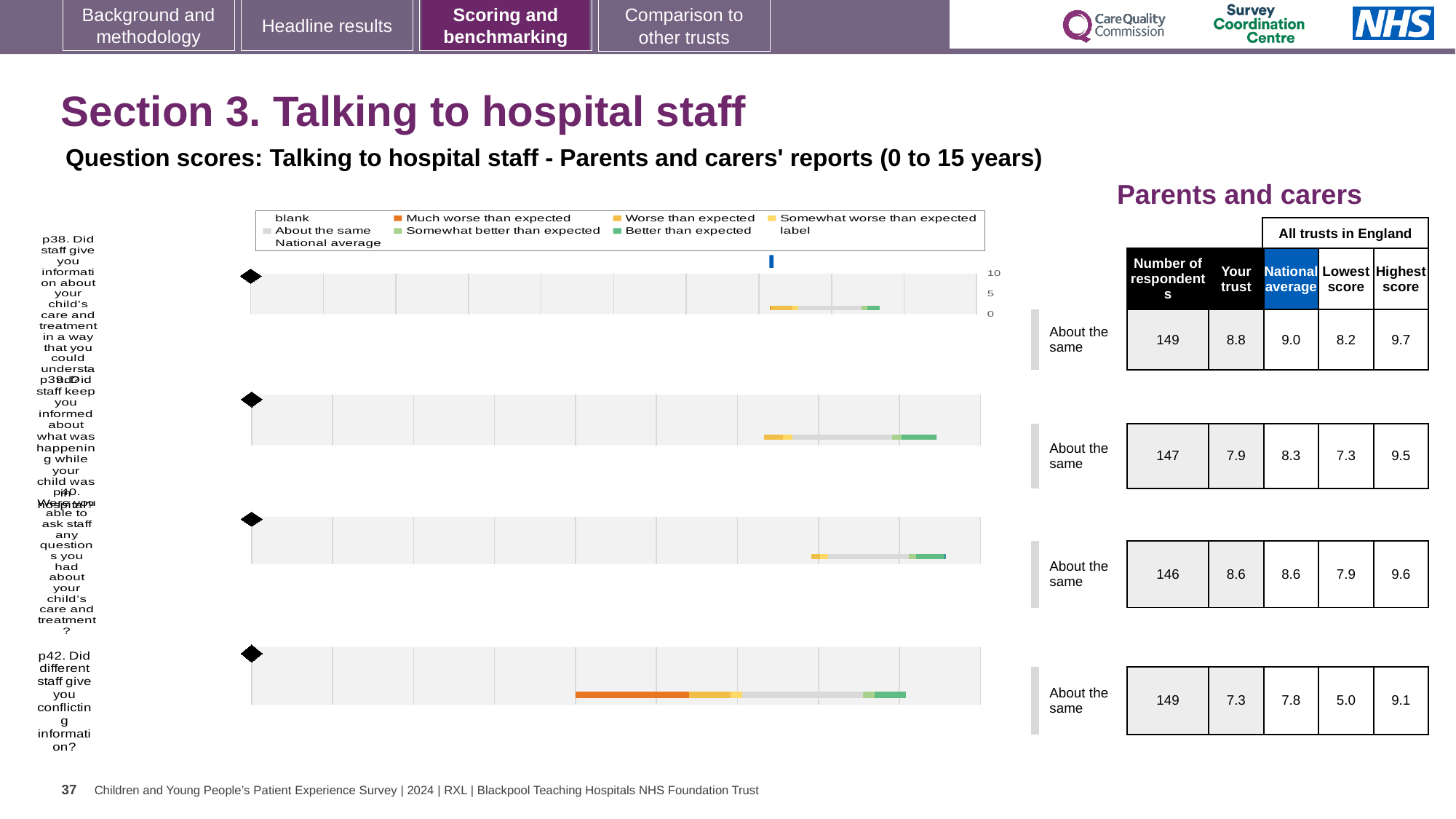
For p42, what is the difference between the highest score and the lowest score across all trusts in England? 4.1 How many question charts are shown on the slide? 4 How many entries does the chart legend list? 9 Which question has the highest 'Your trust' score? p38 What kind of chart is used to show the question scores for p38? bar chart What is the 'Your trust' score for p38 (staff giving information about your child's care and treatment in a way you could understand)? 8.8 What colour represents 'Better than expected' in the chart legend? green For p39, which is larger: the 'Your trust' score or the national average? National average What colour represents 'Much worse than expected' in the chart legend? orange How many respondents answered p40 (were you able to ask staff any questions about your child's care and treatment)? 146 Which question has the lowest 'Your trust' score? p42 What is the national average score for p42 (different staff giving conflicting information)? 7.8